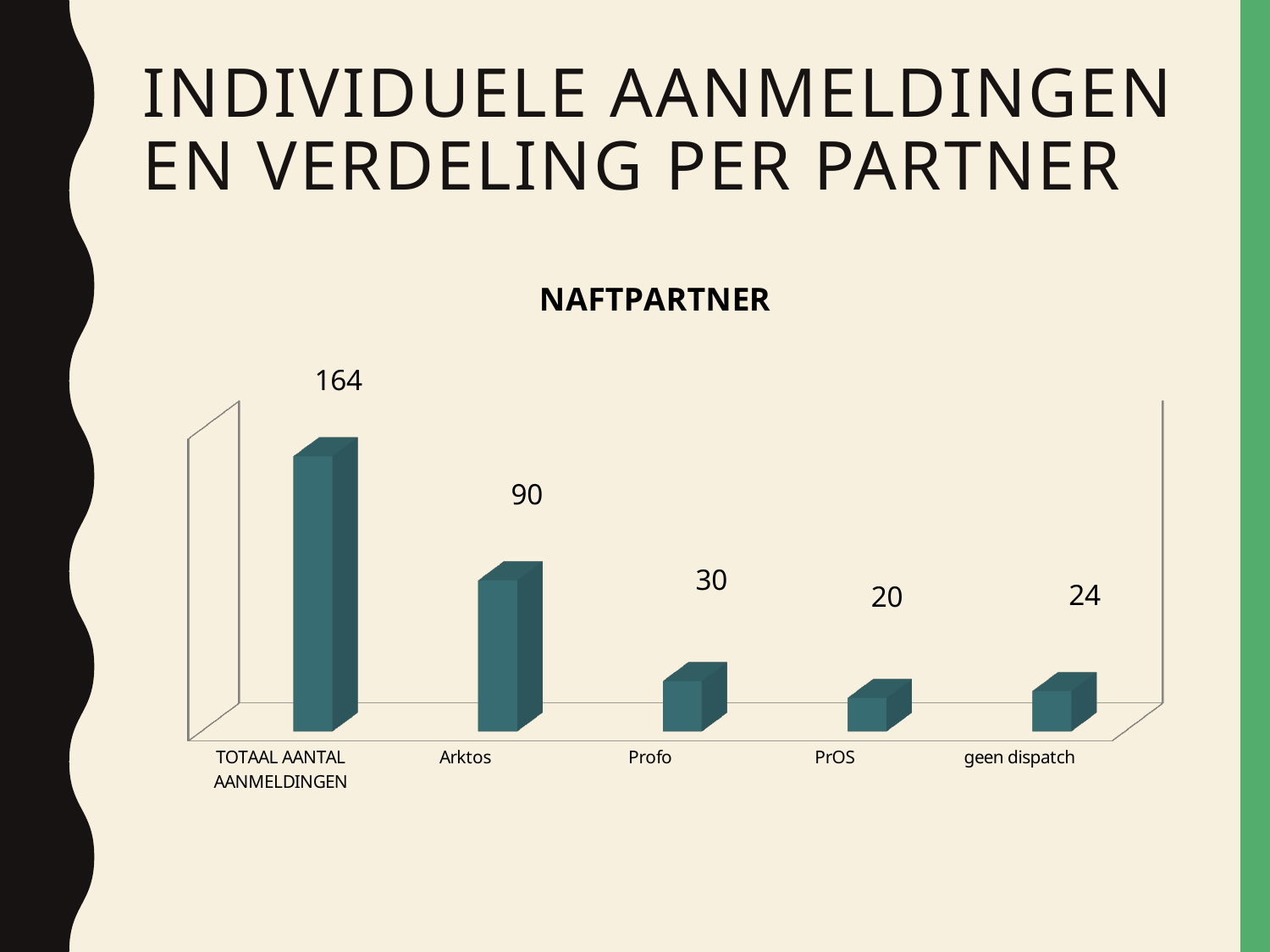
What is the value for PrOS? 20 What is the value for TOTAAL AANTAL AANMELDINGEN? 164 What is the value for Profo? 30 Which is larger, the value for geen dispatch or the value for PrOS? geen dispatch Which category has the lowest value? PrOS What is the title of the chart? NAFTPARTNER What is the difference between the values for Arktos and Profo? 60 What is the value for geen dispatch? 24 How many categories are shown on the x axis? 5 What kind of chart is shown on the slide? bar chart Which category has the highest value? TOTAAL AANTAL AANMELDINGEN What is the value for Arktos? 90